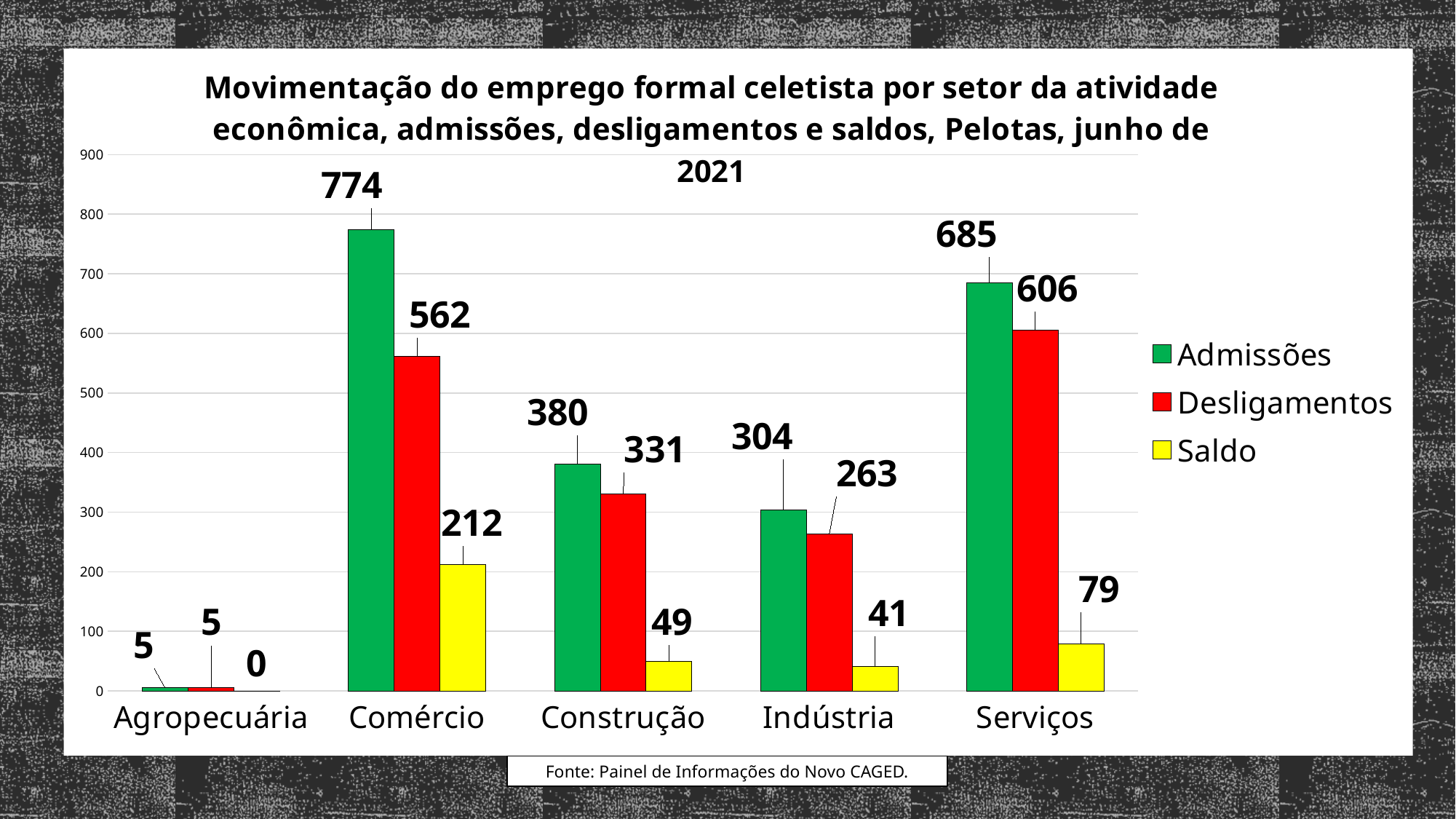
What is the Saldo value for Indústria? 41 How many sectors are shown on the x axis? 5 Is the Desligamentos value for Indústria greater or less than 300? less Which colour represents the Saldo series? yellow Which sector has the highest Admissões value? Comércio What is the value of Desligamentos for Serviços? 606 Which is larger: Desligamentos for Comércio or Admissões for Serviços? Admissões for Serviços Which sector has the lowest Saldo value? Agropecuária What is the value of Admissões for Comércio? 774 What is the difference between Admissões and Desligamentos for Construção? 49 How many series does the legend list? 3 What kind of chart is shown on the slide? bar chart